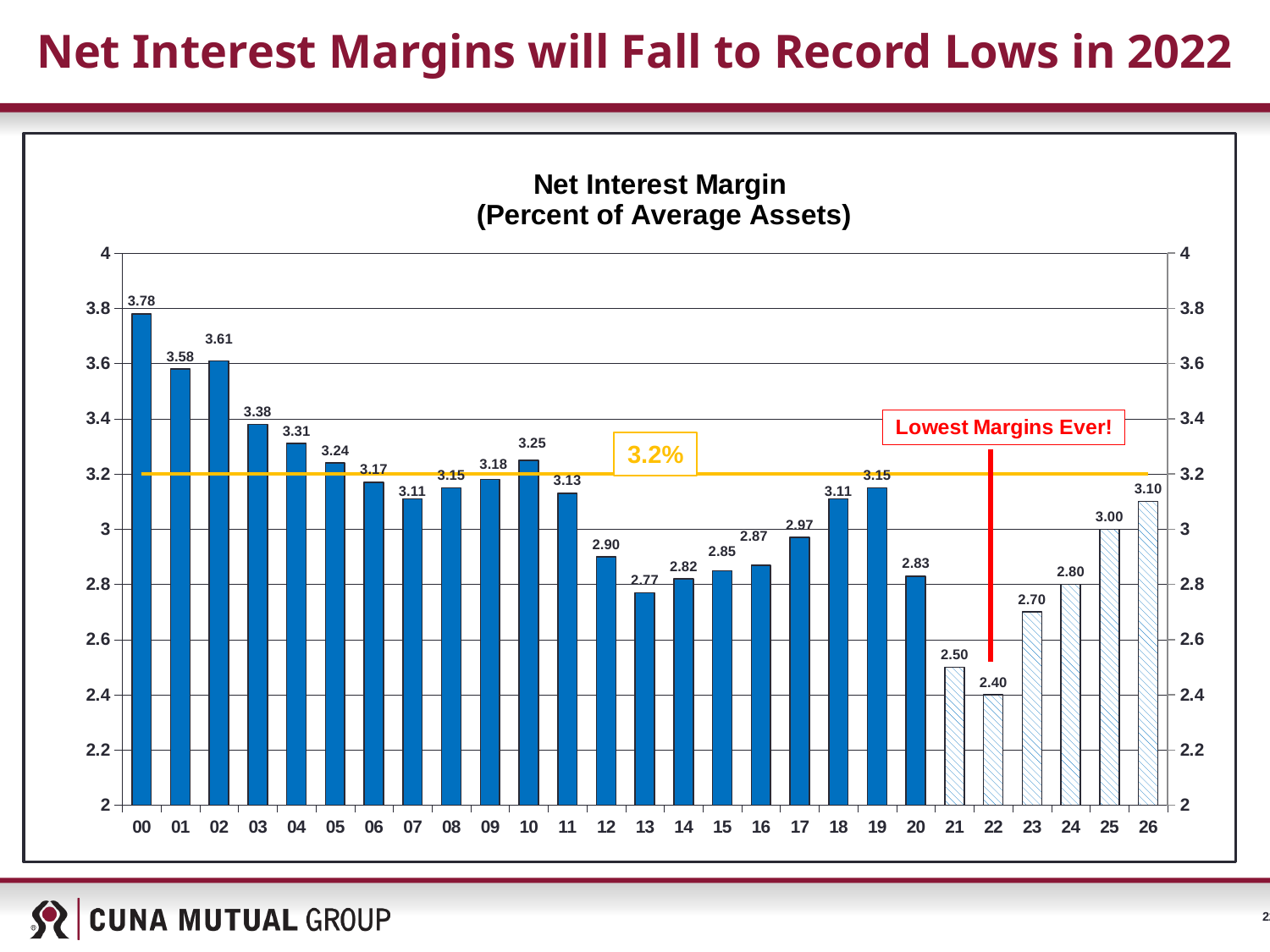
What value is labelled on the horizontal reference line in the chart? 3.2% How many years are shown on the x axis of the chart? 27 What is the difference between the net interest margin in 2000 (00) and 2022 (22)? 1.38 Which year has the highest net interest margin? 00 Do the net interest margin values rise or fall from 2022 (22) to 2026 (26)? rise What is the net interest margin value for 2022 (22)? 2.40 Which year has the lowest net interest margin? 22 Is the net interest margin for 2010 (10) greater or less than 3.2? greater Which is larger, the net interest margin for 2019 (19) or for 2020 (20)? 19 What is the net interest margin value for 2013 (13)? 2.77 What is the net interest margin value for 2000 (00)? 3.78 What kind of chart is shown on the slide? bar chart